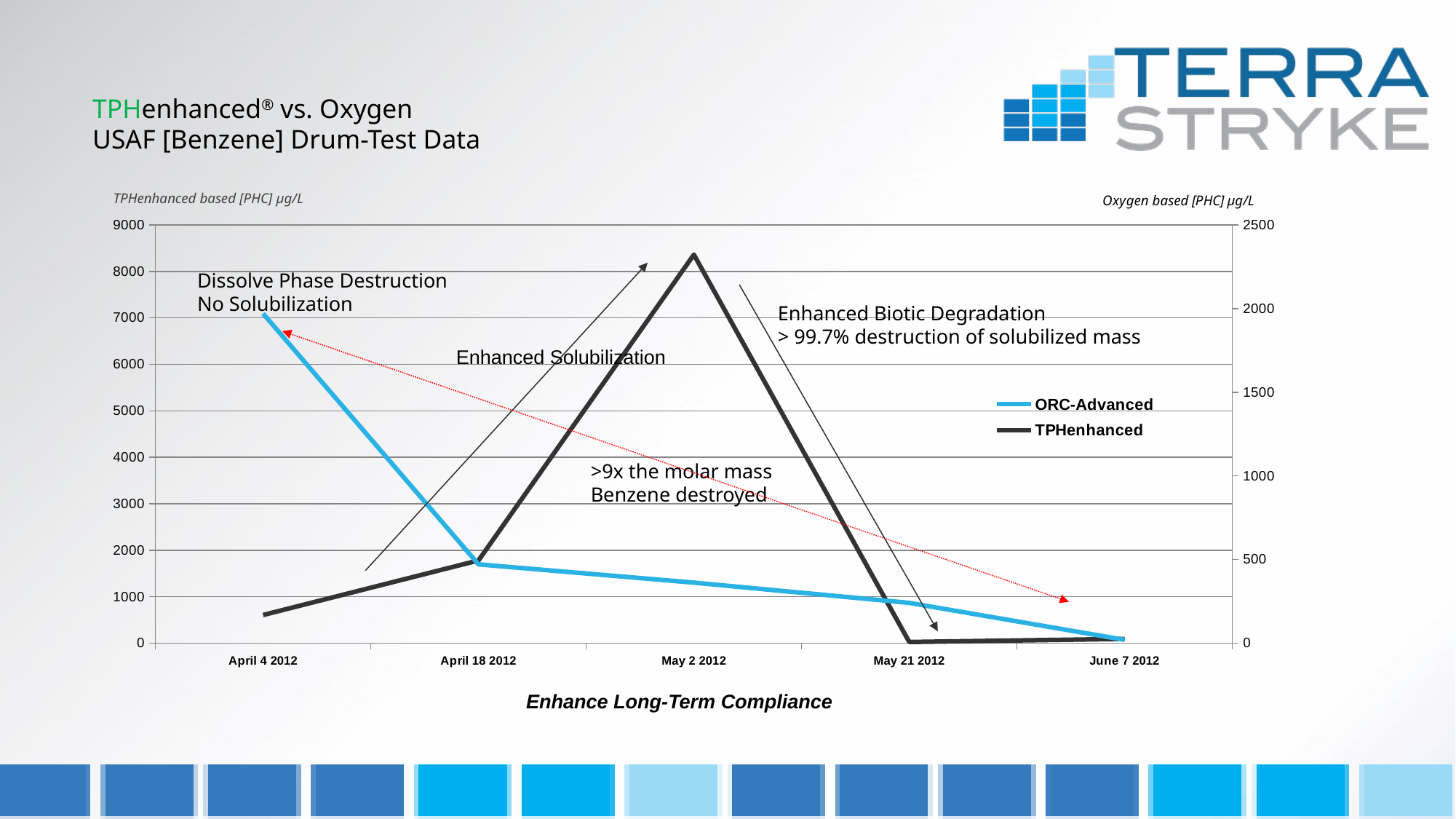
On which date does the TPHenhanced series reach its lowest value? May 21 2012 On which date does the ORC-Advanced series reach its highest value? April 4 2012 What is the title of the right-hand vertical axis of the chart? Oxygen based [PHC] µg/L Does the ORC-Advanced series rise or fall from April 4 2012 to June 7 2012? fall On the right axis, is the ORC-Advanced value for April 4 2012 greater or less than 1500? greater On the left axis, is the TPHenhanced value for April 4 2012 greater or less than 1000? less On the left axis, is the TPHenhanced value for May 2 2012 greater or less than 8000? greater How many series does the chart legend list? 2 How many dates are plotted along the x axis of the chart? 5 What kind of chart is shown on the slide? line chart What are the two series names listed in the chart legend? ORC-Advanced and TPHenhanced On which date does the TPHenhanced series reach its highest value? May 2 2012